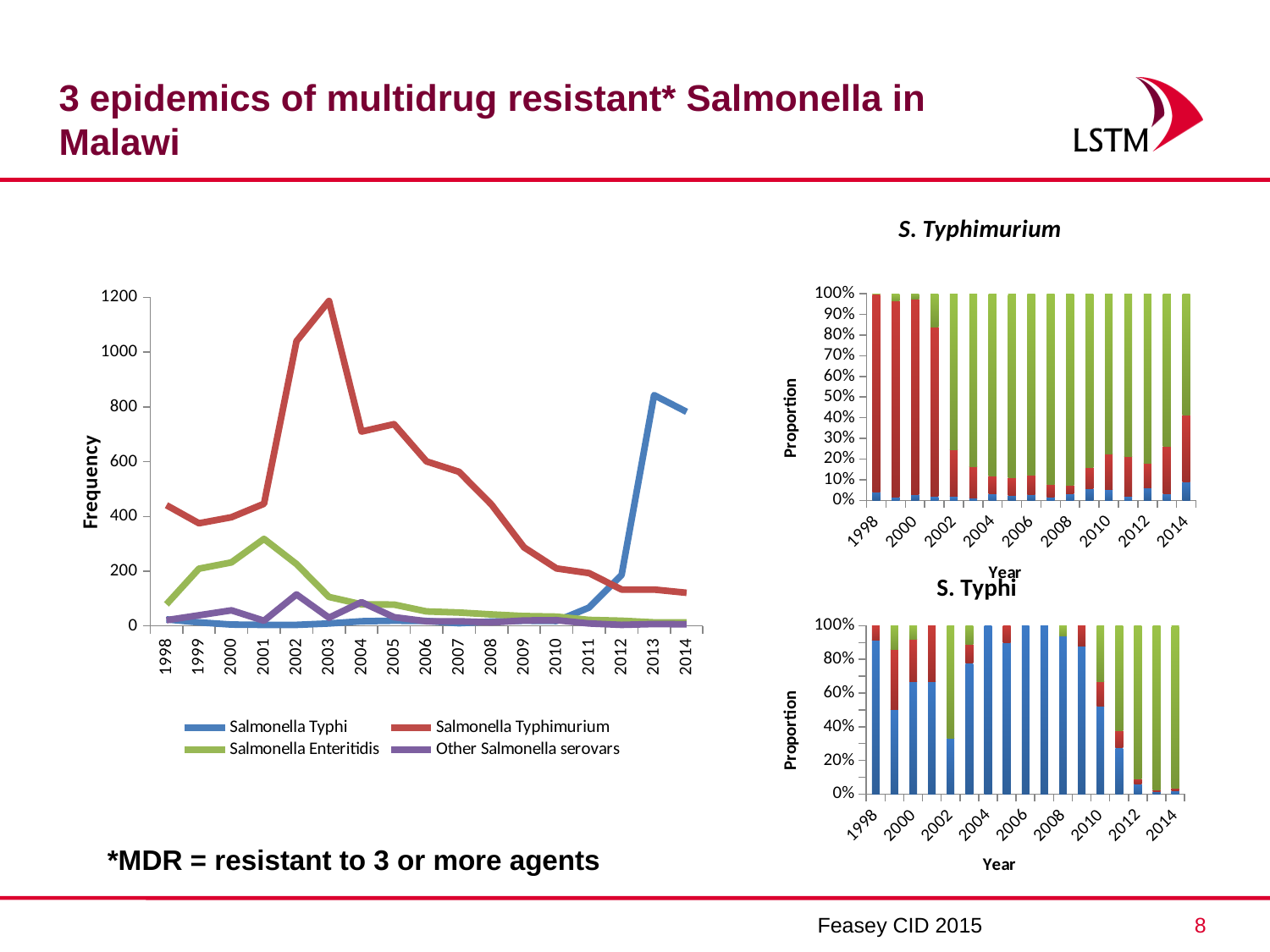
How many series does the legend of the left-hand Frequency chart list? 4 In the left-hand Frequency chart, in which year does Salmonella Typhi reach its highest frequency? 2013 In the left-hand Frequency chart, is the frequency of Salmonella Enteritidis in 2001 greater or less than 200? greater What kind of chart is the S. Typhi chart on the right of the slide? bar chart What kind of chart is the left-hand chart with the Frequency axis? line chart How many years are plotted along the x axis of the left-hand Frequency chart? 17 In the left-hand Frequency chart, does the frequency of Salmonella Typhimurium rise or fall between 2003 and 2010? fall In the left-hand Frequency chart, which series has the higher frequency in 2002: Salmonella Typhimurium or Salmonella Enteritidis? Salmonella Typhimurium In the left-hand Frequency chart, is the frequency of Salmonella Typhimurium in 2003 greater or less than 1000? greater In the left-hand Frequency chart, what colour is the Salmonella Typhi line according to the legend? blue In the left-hand Frequency chart, in which year does Salmonella Typhimurium reach its highest frequency? 2003 In the left-hand Frequency chart, is the frequency of Salmonella Typhi in 2013 greater or less than 600? greater